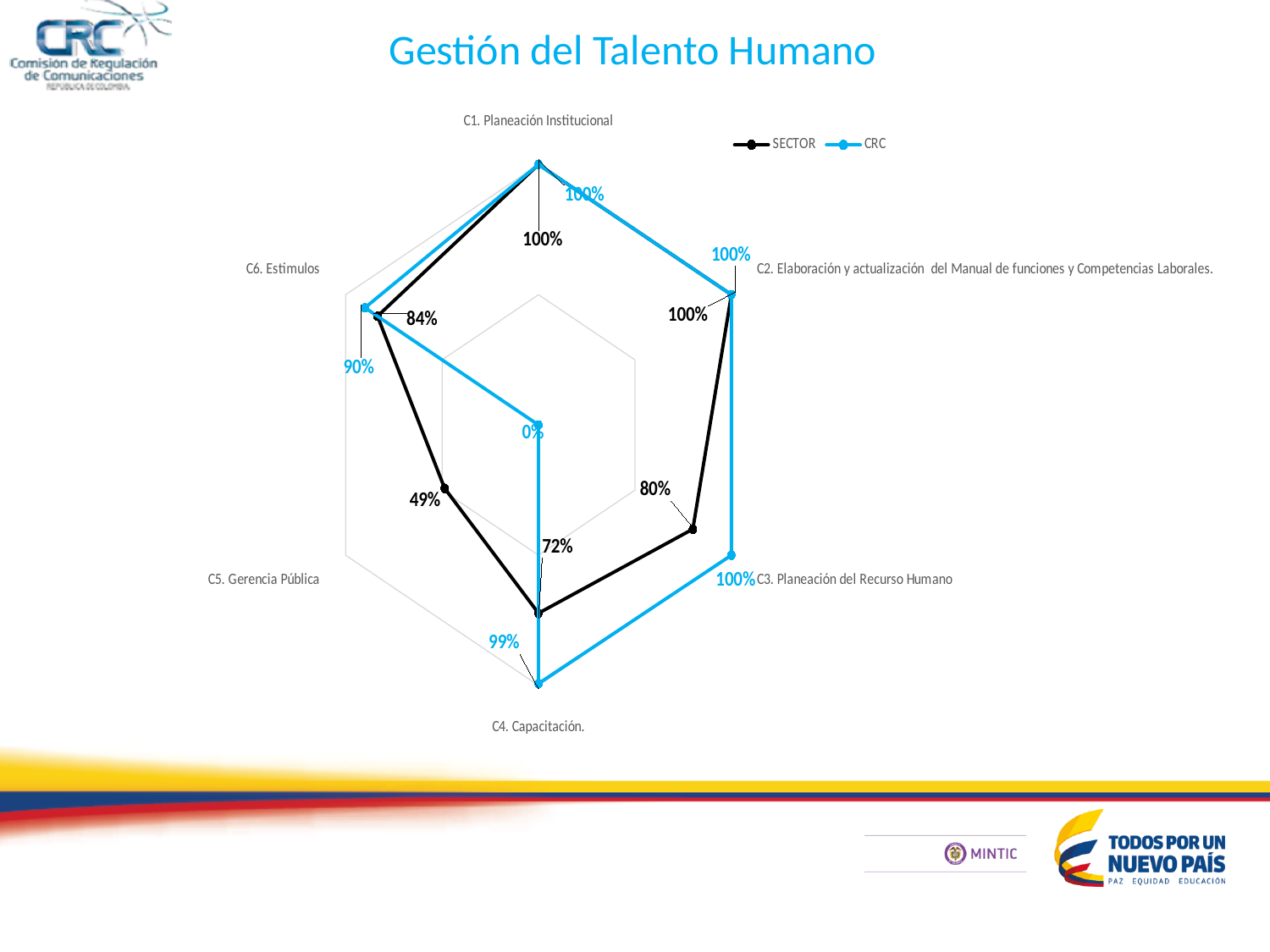
What is the SECTOR value for C3. Planeación del Recurso Humano? 80% What is the CRC value for C6. Estímulos? 90% For C3. Planeación del Recurso Humano, which series has the larger value, SECTOR or CRC? CRC How many categories are plotted on the radar chart? 6 Which category has the lowest CRC value? C5. Gerencia Pública How many series does the legend list? 2 What is the CRC value for C4. Capacitación? 99% What is the title of the chart on the slide? Gestión del Talento Humano What is the difference between the CRC and SECTOR values for C4. Capacitación? 27% What kind of chart is shown on the slide? Radar chart What is the SECTOR value for C5. Gerencia Pública? 49% Which category has the lowest SECTOR value? C5. Gerencia Pública